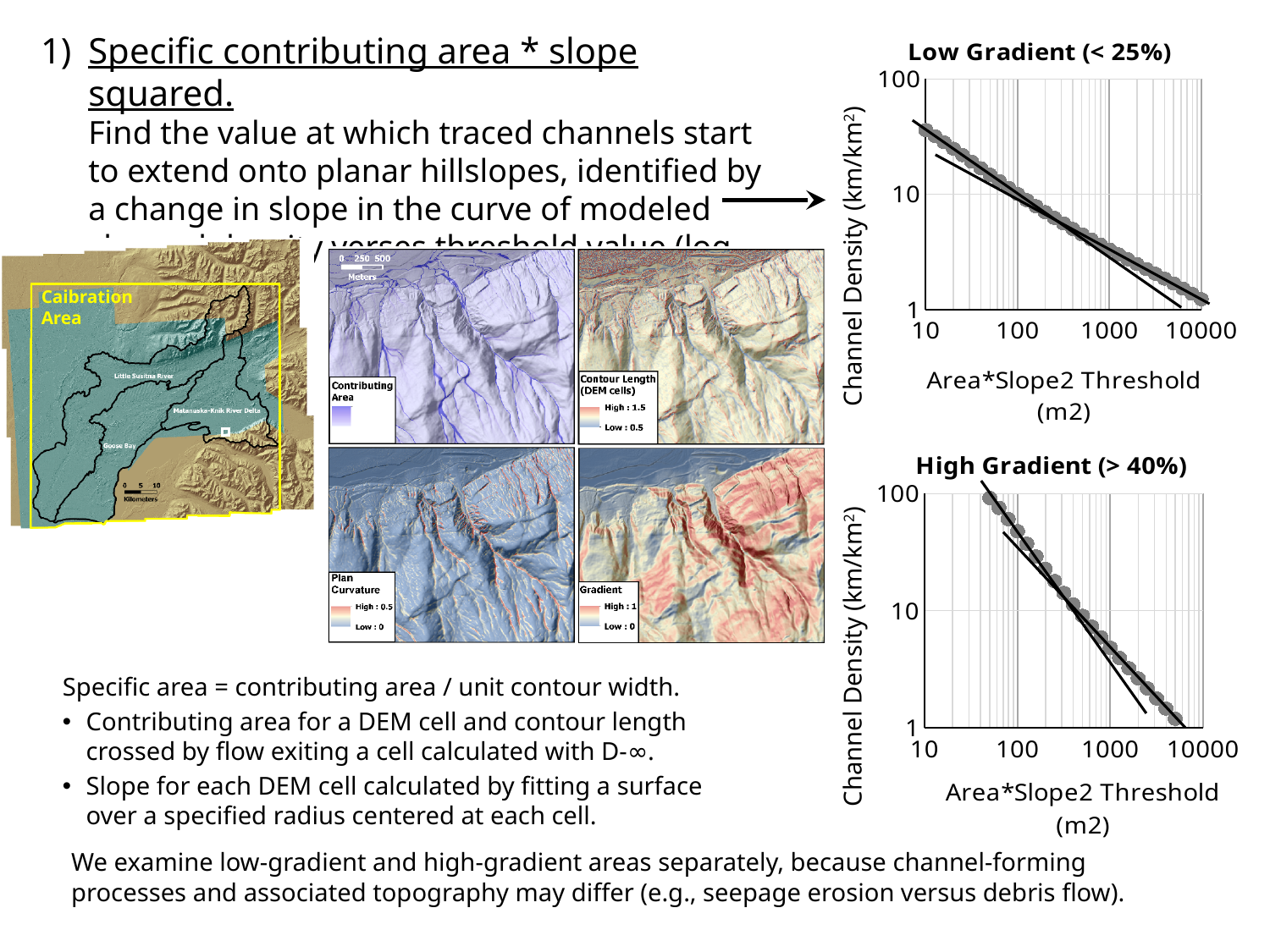
What is the y-axis label of the High Gradient (> 40%) chart? Channel Density (km/km2) In the Low Gradient (< 25%) chart, is the channel density at a threshold of 10 greater or less than 10? greater What kind of chart is the Low Gradient (< 25%) chart? scatter chart In the High Gradient (> 40%) chart, is the channel density at a threshold of 1000 greater or less than 10? less In the High Gradient (> 40%) chart, is the channel density at a threshold of 100 greater or less than 10? greater What kind of chart is the High Gradient (> 40%) chart? scatter chart In the High Gradient (> 40%) chart, does channel density rise or fall as the Area*Slope2 threshold increases? fall In the Low Gradient (< 25%) chart, does channel density rise or fall as the Area*Slope2 threshold increases? fall What is the title of the upper chart on the right of the slide? Low Gradient (< 25%)